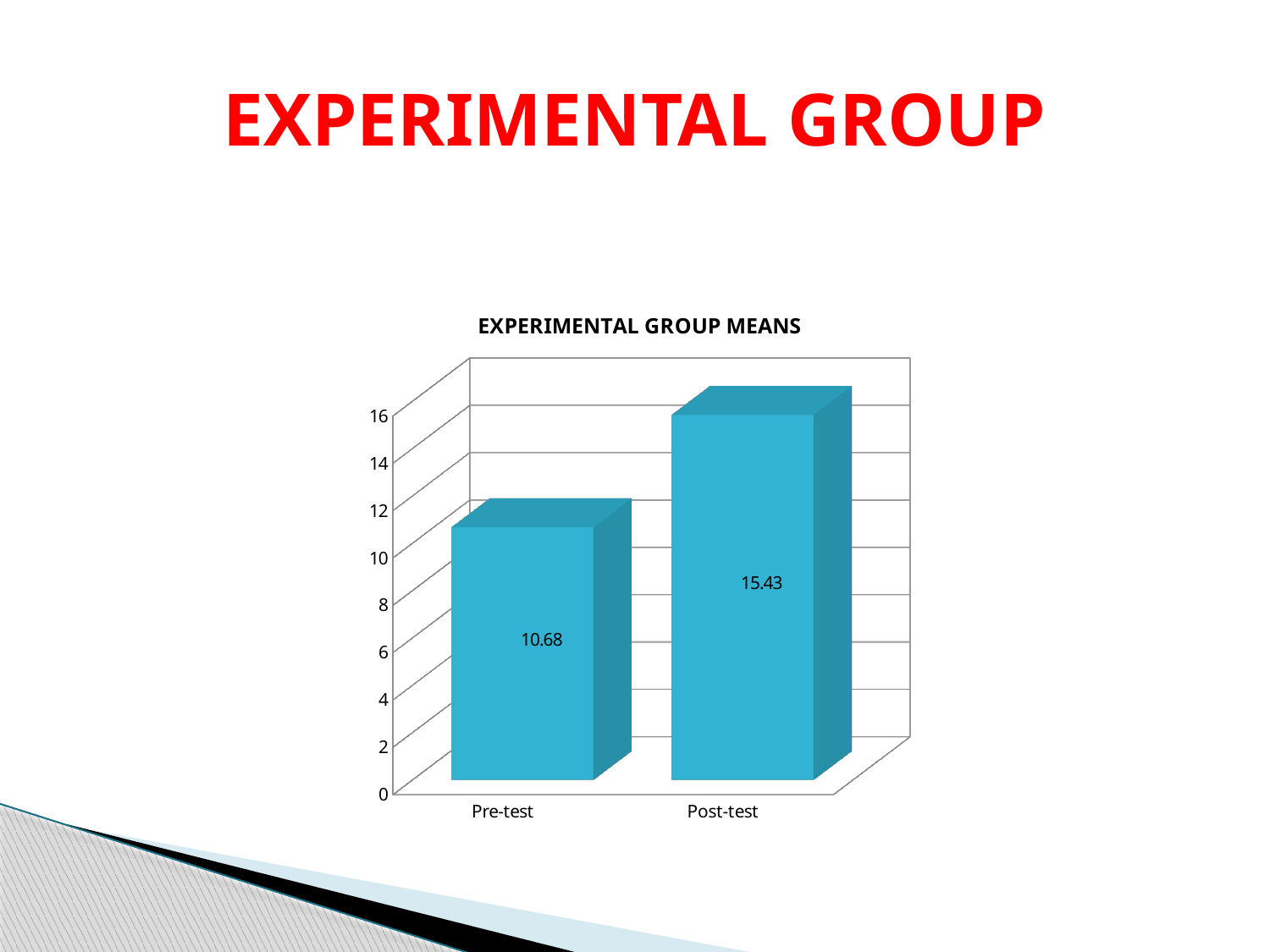
What is the difference between the Post-test and Pre-test values? 4.75 How many categories are shown on the chart? 2 Which category has the lowest value? Pre-test What kind of chart is shown on the slide? Bar chart Do the values rise or fall from Pre-test to Post-test? Rise Which is larger, the Pre-test value or the Post-test value? Post-test What is the value for Pre-test? 10.68 Is the value for Post-test greater or less than 14? greater Is the value for Pre-test greater or less than 12? less What is the title of the chart? EXPERIMENTAL GROUP MEANS Which category has the highest value? Post-test What is the value for Post-test? 15.43